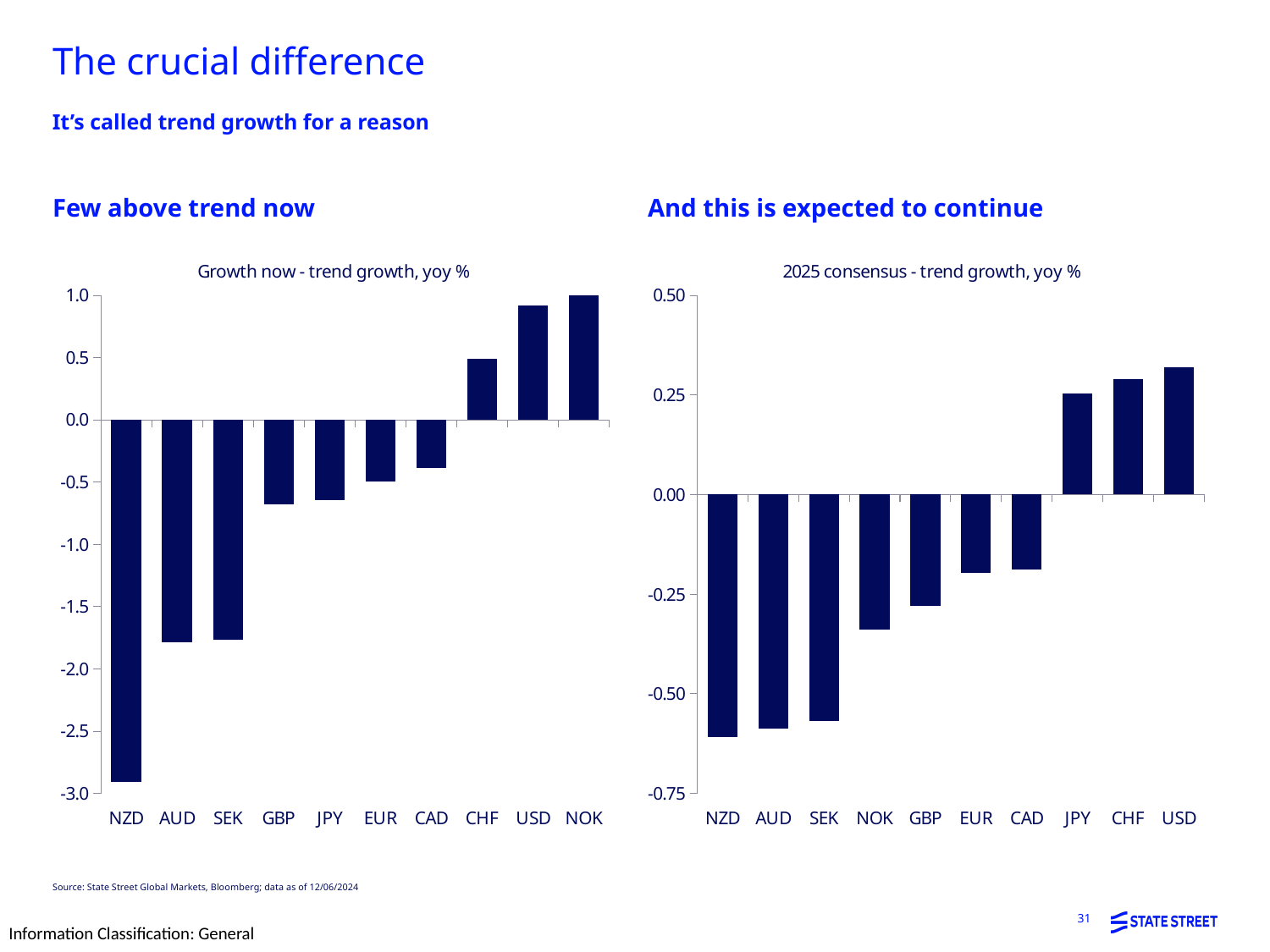
On the right chart, '2025 consensus - trend growth, yoy %', is the value for NOK greater or less than -0.25? less On the left chart, 'Growth now - trend growth, yoy %', do the values rise or fall moving from left to right along the x axis? rise What is the title of the right chart? 2025 consensus - trend growth, yoy % On the left chart, 'Growth now - trend growth, yoy %', which currency has the lowest value? NZD On the left chart, 'Growth now - trend growth, yoy %', which is larger, the value for CAD or the value for EUR? CAD On the left chart, 'Growth now - trend growth, yoy %', is the value for USD greater or less than 0.5? greater On the right chart, '2025 consensus - trend growth, yoy %', which currency has the lowest value? NZD What kind of chart is the left chart titled 'Growth now - trend growth, yoy %'? bar chart On the left chart, 'Growth now - trend growth, yoy %', which currency has the highest value? NOK How many currencies are shown on the left chart, 'Growth now - trend growth, yoy %'? 10 On the right chart, '2025 consensus - trend growth, yoy %', which currency has the highest value? USD On the left chart, 'Growth now - trend growth, yoy %', is the value for NZD greater or less than -2.5? less